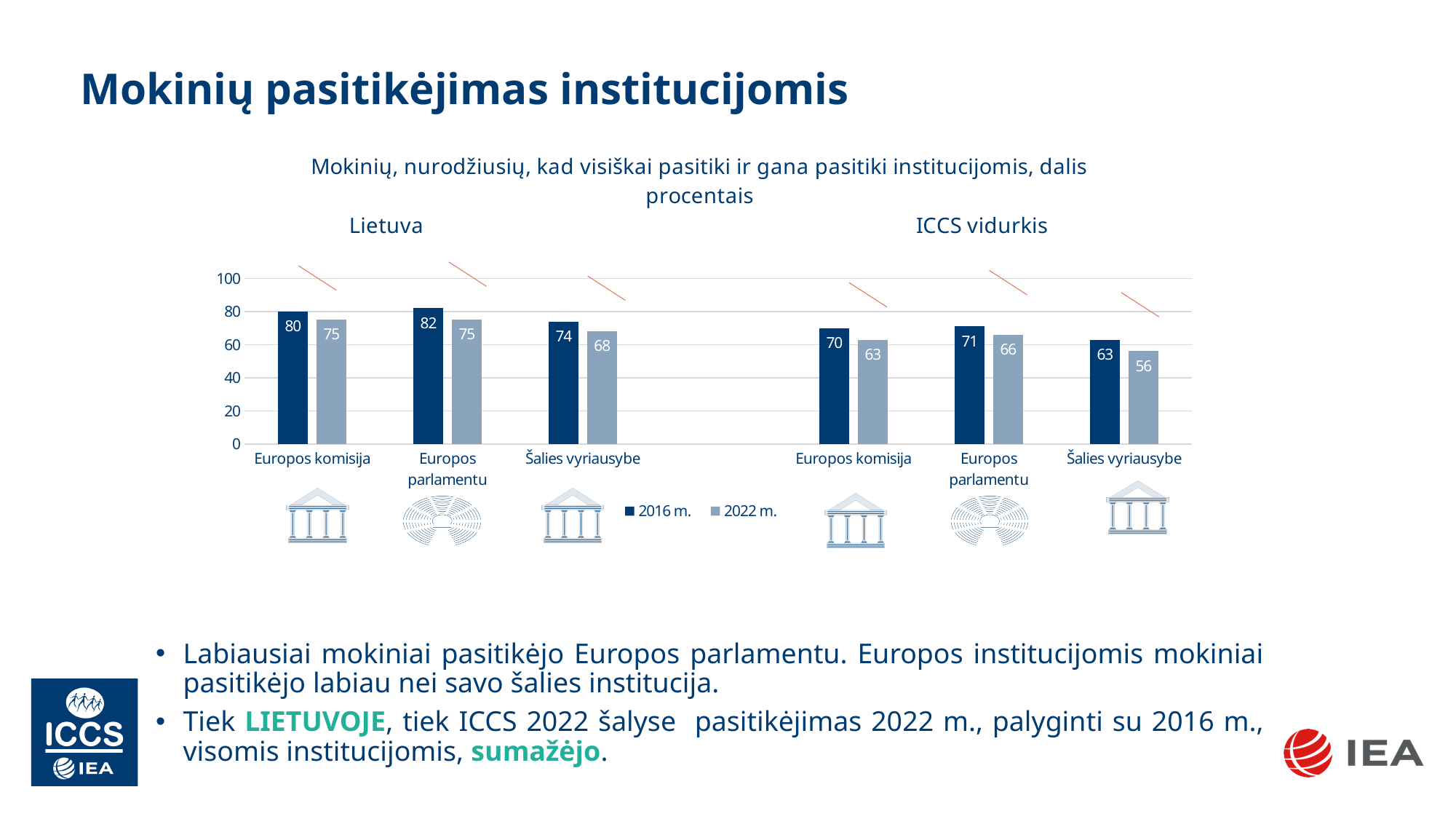
What are the two group headings shown above the chart? Lietuva and ICCS vidurkis How many series does the legend list? 2 Which category in the ICCS vidurkis group has the highest 2016 m. value? Europos parlamentu What is the 2022 m. value for Šalies vyriausybe in the ICCS vidurkis group? 56 Which is larger: the 2022 m. value for Europos parlamentu in the Lietuva group or in the ICCS vidurkis group? Lietuva Which category in the Lietuva group has the lowest 2022 m. value? Šalies vyriausybe What is the difference between the 2016 m. and 2022 m. values for Šalies vyriausybe in the ICCS vidurkis group? 7 What is the 2022 m. value for Europos komisija in the Lietuva group? 75 What is the 2016 m. value for Europos parlamentu in the Lietuva group? 82 Within each category, do the values fall or rise from 2016 m. to 2022 m.? Fall What is the difference between the Lietuva and ICCS vidurkis 2016 m. values for Europos komisija? 10 What kind of chart is shown on the slide? Bar chart